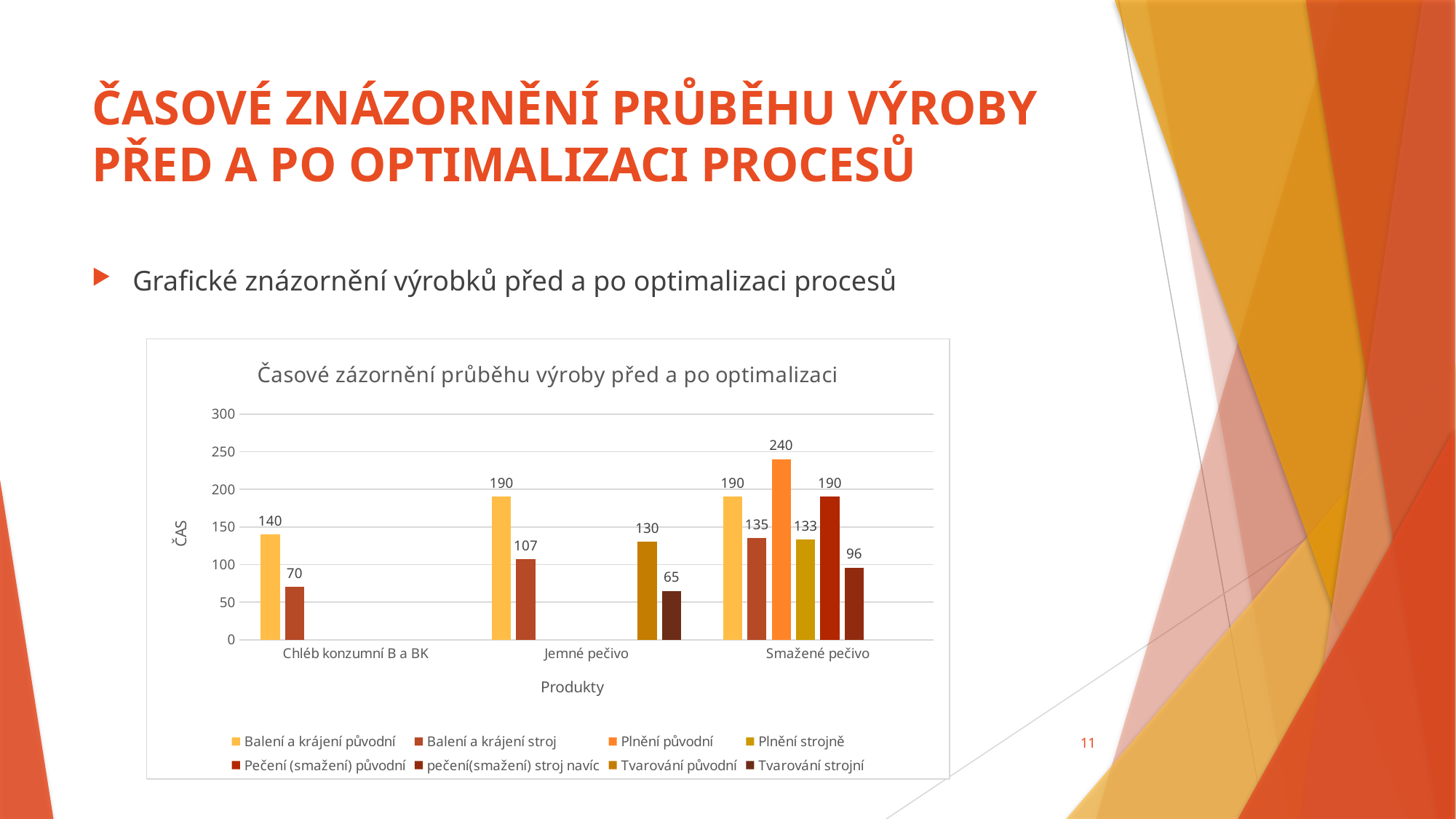
How many series does the legend list? 8 What is the value of Plnění původní for Smažené pečivo? 240 What is the value of Balení a krájení stroj for Jemné pečivo? 107 What is the difference between Balení a krájení původní and Balení a krájení stroj for Chléb konzumní B a BK? 70 What is the value of Balení a krájení stroj for Chléb konzumní B a BK? 70 What type of chart is shown on the slide? Bar chart What is the value of Balení a krájení původní for Jemné pečivo? 190 Which is larger: Balení a krájení stroj for Jemné pečivo or for Smažené pečivo? Smažené pečivo What is the value of Balení a krájení původní for Chléb konzumní B a BK? 140 What is the highest value shown in the chart? 240 What is the lowest value shown in the chart? 65 How many product categories are shown on the x axis? 3